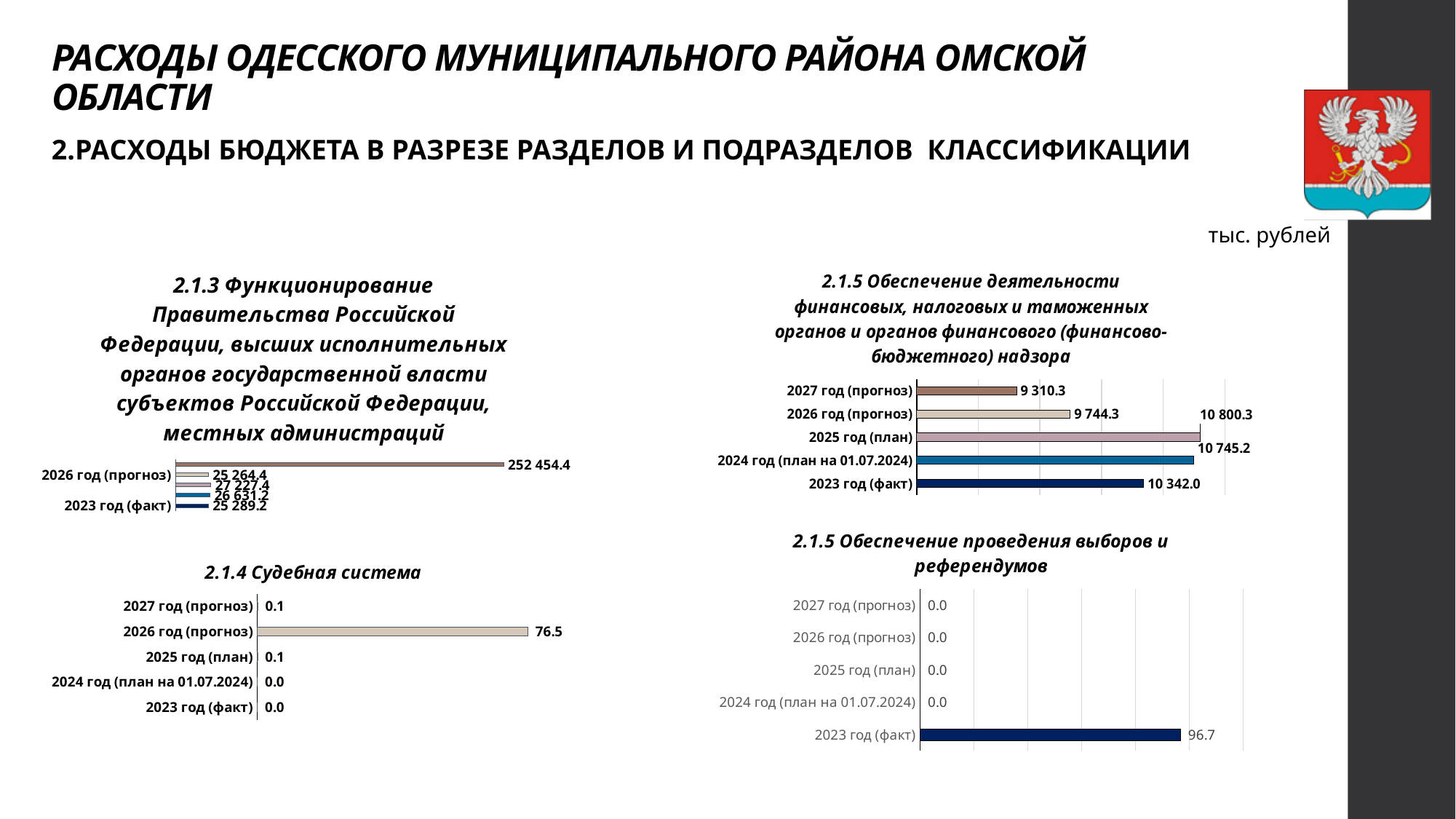
In the chart '2.1.5 Обеспечение проведения выборов и референдумов', what is the value for 2025 год (план)? 0.0 In the chart '2.1.3 Функционирование Правительства Российской Федерации...', what is the value for 2023 год (факт)? 25 289.2 In the chart '2.1.5 Обеспечение деятельности финансовых, налоговых и таможенных органов...', which is larger: the value for 2023 год (факт) or 2026 год (прогноз)? 2023 год (факт) In the chart '2.1.4 Судебная система', what is the value for 2026 год (прогноз)? 76.5 In the chart '2.1.5 Обеспечение деятельности финансовых, налоговых и таможенных органов...', what is the value for 2027 год (прогноз)? 9 310.3 In the chart '2.1.4 Судебная система', how many categories are shown? 5 In the chart '2.1.5 Обеспечение деятельности финансовых, налоговых и таможенных органов...', what is the difference between the values for 2025 год (план) and 2024 год (план на 01.07.2024)? 55.1 In the chart '2.1.4 Судебная система', which category has the highest value? 2026 год (прогноз) What kind of chart is '2.1.4 Судебная система'? bar chart In the chart '2.1.5 Обеспечение деятельности финансовых, налоговых и таможенных органов...', what is the value for 2025 год (план)? 10 800.3 In the chart '2.1.5 Обеспечение деятельности финансовых, налоговых и таможенных органов...', which category has the lowest value? 2027 год (прогноз) In the chart '2.1.5 Обеспечение проведения выборов и референдумов', what is the value for 2023 год (факт)? 96.7